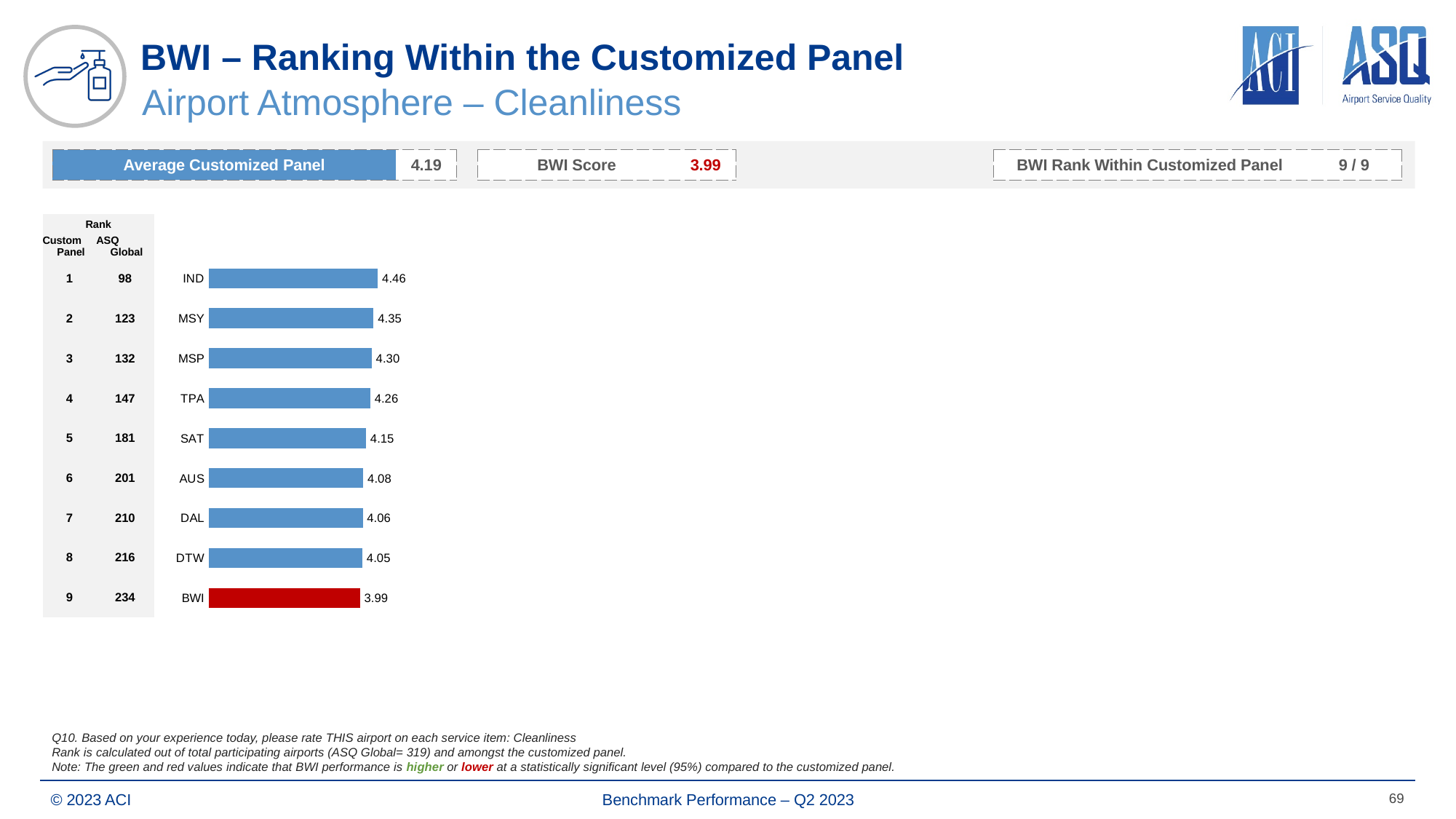
Which has a higher cleanliness score, MSP or AUS? MSP How many airports are shown in the chart? 9 What type of chart is shown on the slide? Bar chart Which airport has the highest cleanliness score? IND What is the cleanliness score for IND? 4.46 What is the cleanliness score for SAT? 4.15 Which bar in the chart is coloured red? BWI Which airport has the lowest cleanliness score? BWI What is the cleanliness score for BWI? 3.99 What is the difference between the scores of IND and BWI? 0.47 What is the Average Customized Panel score shown on the slide? 4.19 What is the difference between the scores of MSY and TPA? 0.09